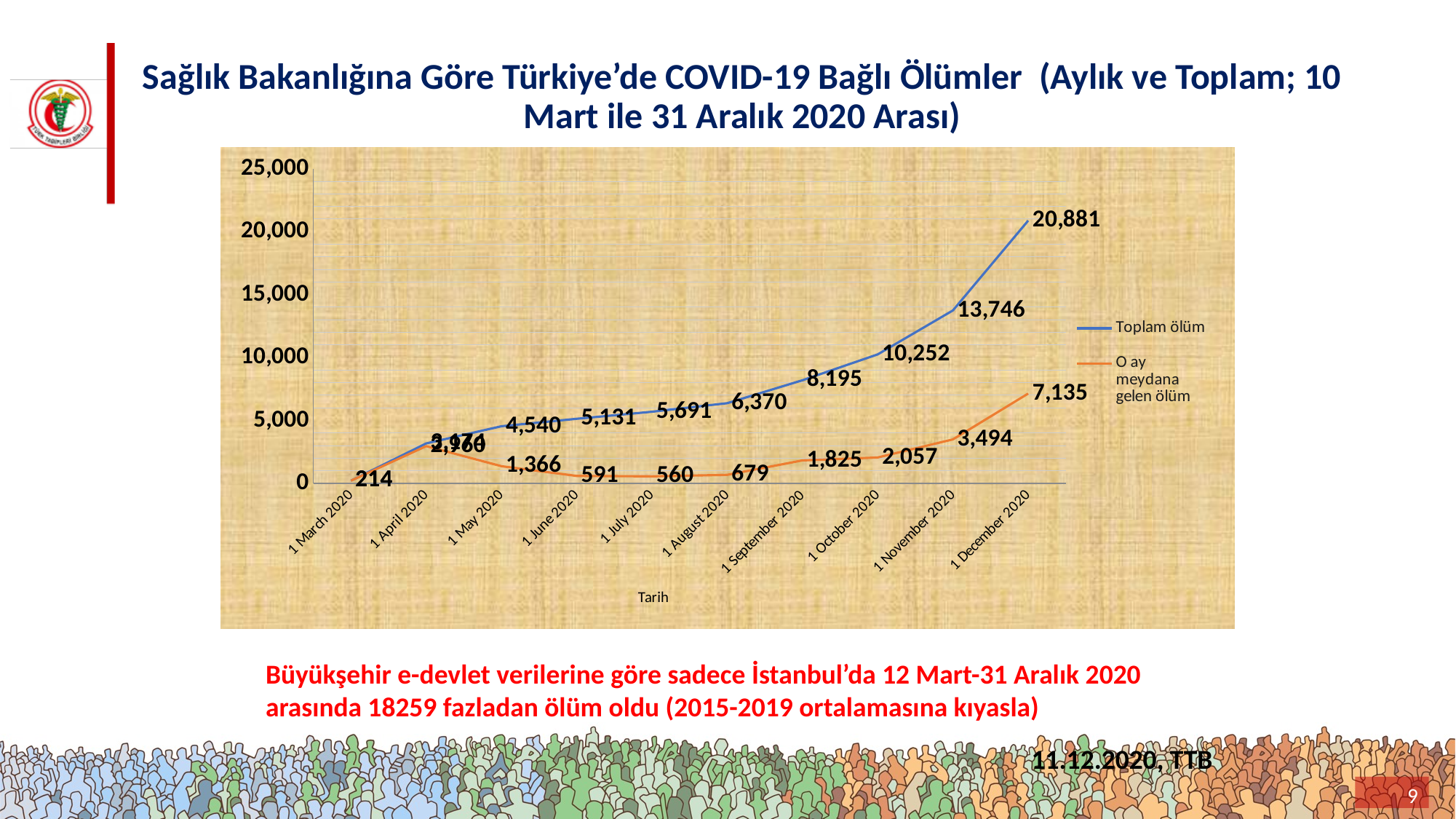
What is the difference between O ay meydana gelen ölüm at 1 November 2020 and at 1 October 2020? 1,437 At which date is O ay meydana gelen ölüm highest? 1 December 2020 Which is larger: O ay meydana gelen ölüm at 1 September 2020 or at 1 August 2020? 1 September 2020 How many series does the chart legend list? 2 Does the Toplam ölüm series rise or fall along the x axis? rise What is the value of O ay meydana gelen ölüm at 1 December 2020? 7,135 What is the value of Toplam ölüm at 1 October 2020? 10,252 How many dates are plotted along the x axis of the chart? 10 What is the value of O ay meydana gelen ölüm at 1 July 2020? 560 What is the value of Toplam ölüm at 1 December 2020? 20,881 What kind of chart is shown on the slide? line chart By how much did Toplam ölüm increase from 1 November 2020 to 1 December 2020? 7,135